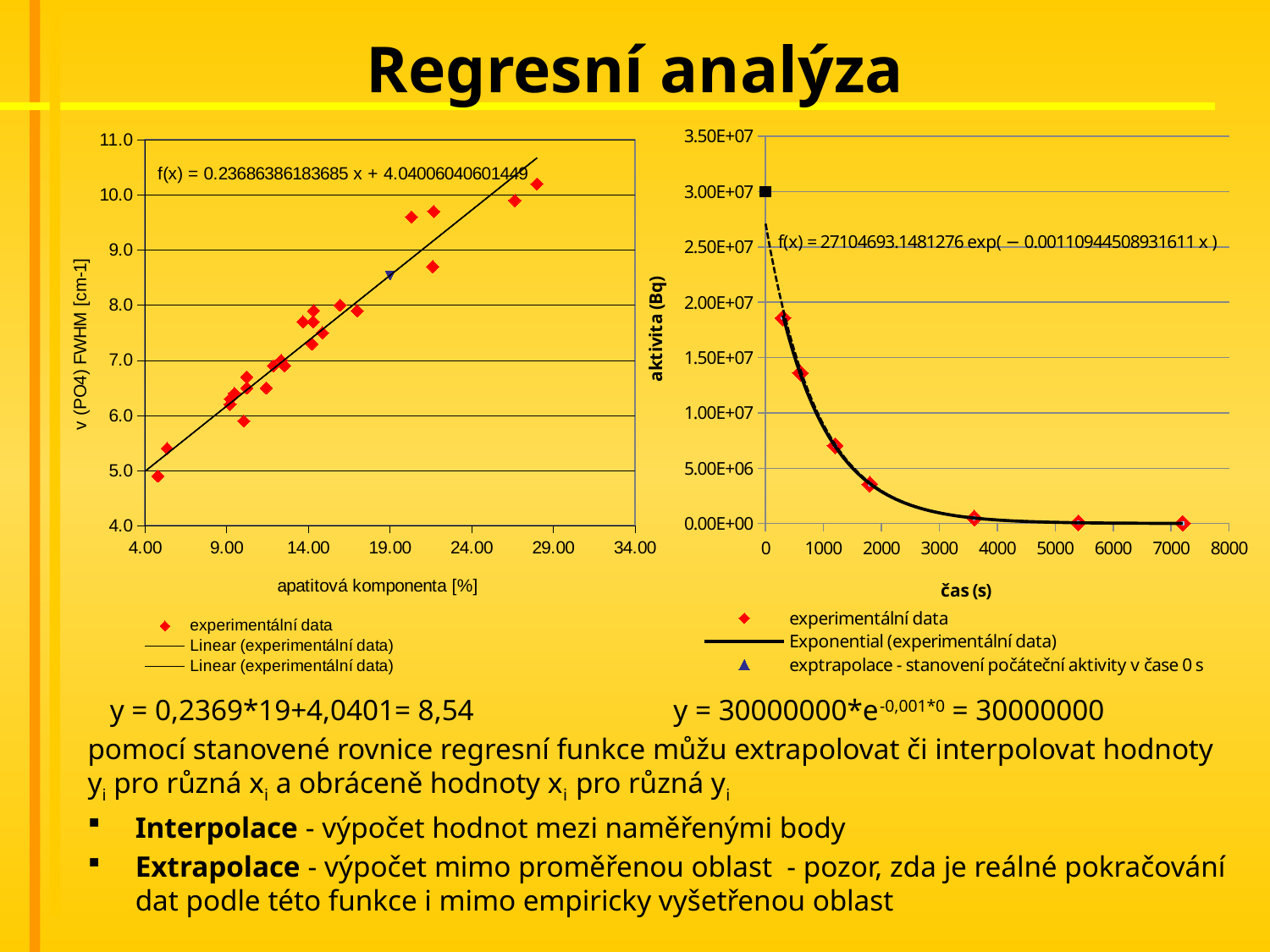
In the left chart, is the highest experimental data point greater or less than 10.0 on the y axis? greater How many entries does the legend of the left chart list? 3 In the right chart, how many red experimental data points are plotted? 7 In the right chart, is the aktivita value at čas 1800 s greater or less than 5.00E+06? less In the right chart, is the aktivita value at čas 600 s greater or less than 1.00E+07? greater What kind of chart is the left chart (apatitová komponenta vs. v (PO4) FWHM)? scatter chart What is the x-axis title of the right chart? čas (s) In the left chart, do the experimental data values rise or fall as apatitová komponenta increases? rise How many entries does the legend of the right chart list? 3 In the right chart, what is the extrapolated aktivita value at čas 0 s? 3.00E+07 What kind of chart is the right chart (aktivita vs. čas)? scatter chart In the right chart, does aktivita rise or fall as čas increases? fall